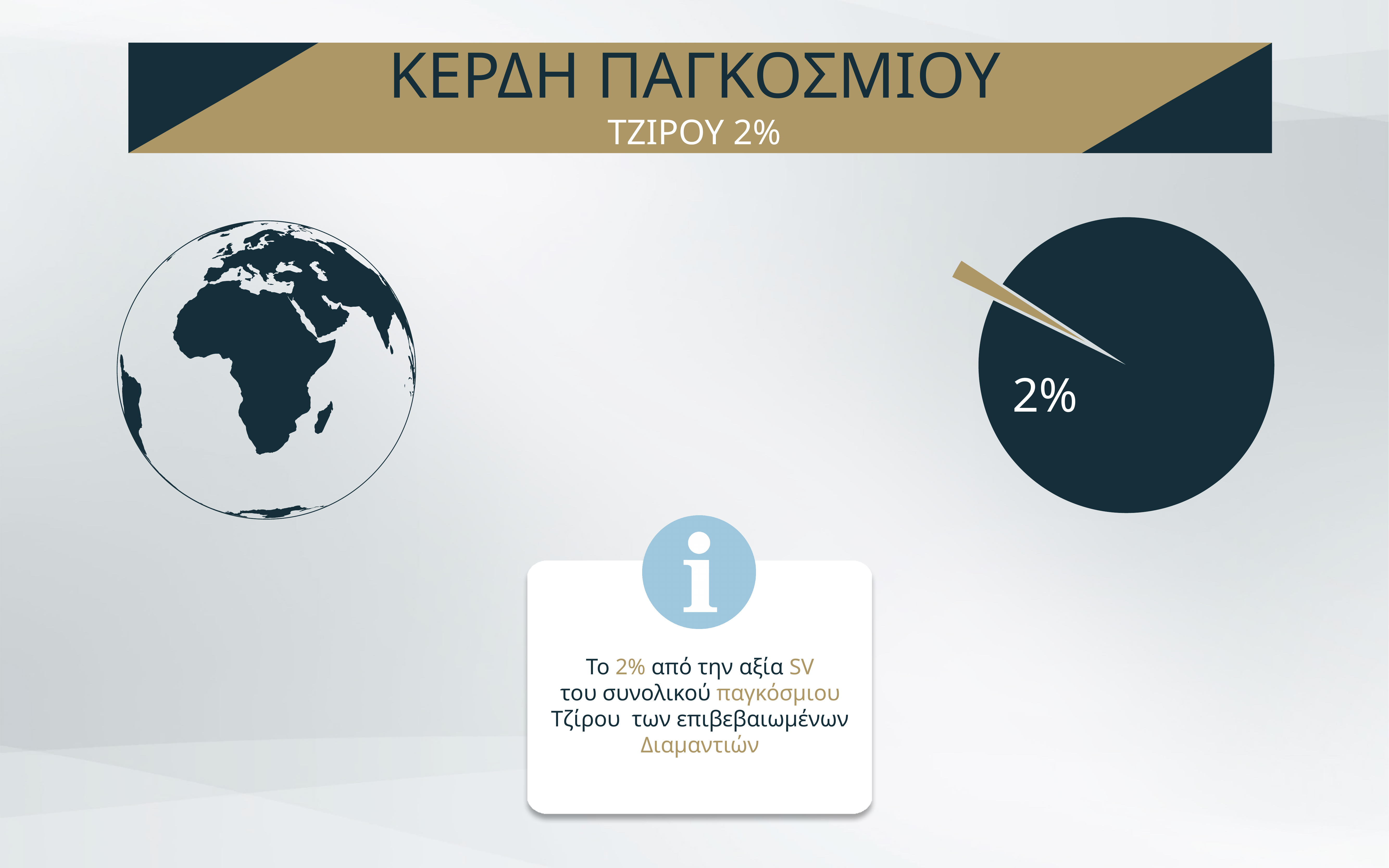
How many slices does the pie chart have? 2 What value is printed as a data label on the pie chart? 2% What kind of chart is shown on the right side of the slide? pie chart Which slice of the pie chart is the smallest? the gold 2% slice Which slice of the pie chart is larger, the dark slice or the gold slice? the dark slice What colour is the small 2% slice of the pie chart? gold What is the title shown in the banner at the top of the slide? ΚΕΡΔΗ ΠΑΓΚΟΣΜΙΟΥ ΤΖΙΡΟΥ 2% What share of the pie does the small gold slice represent? 2%